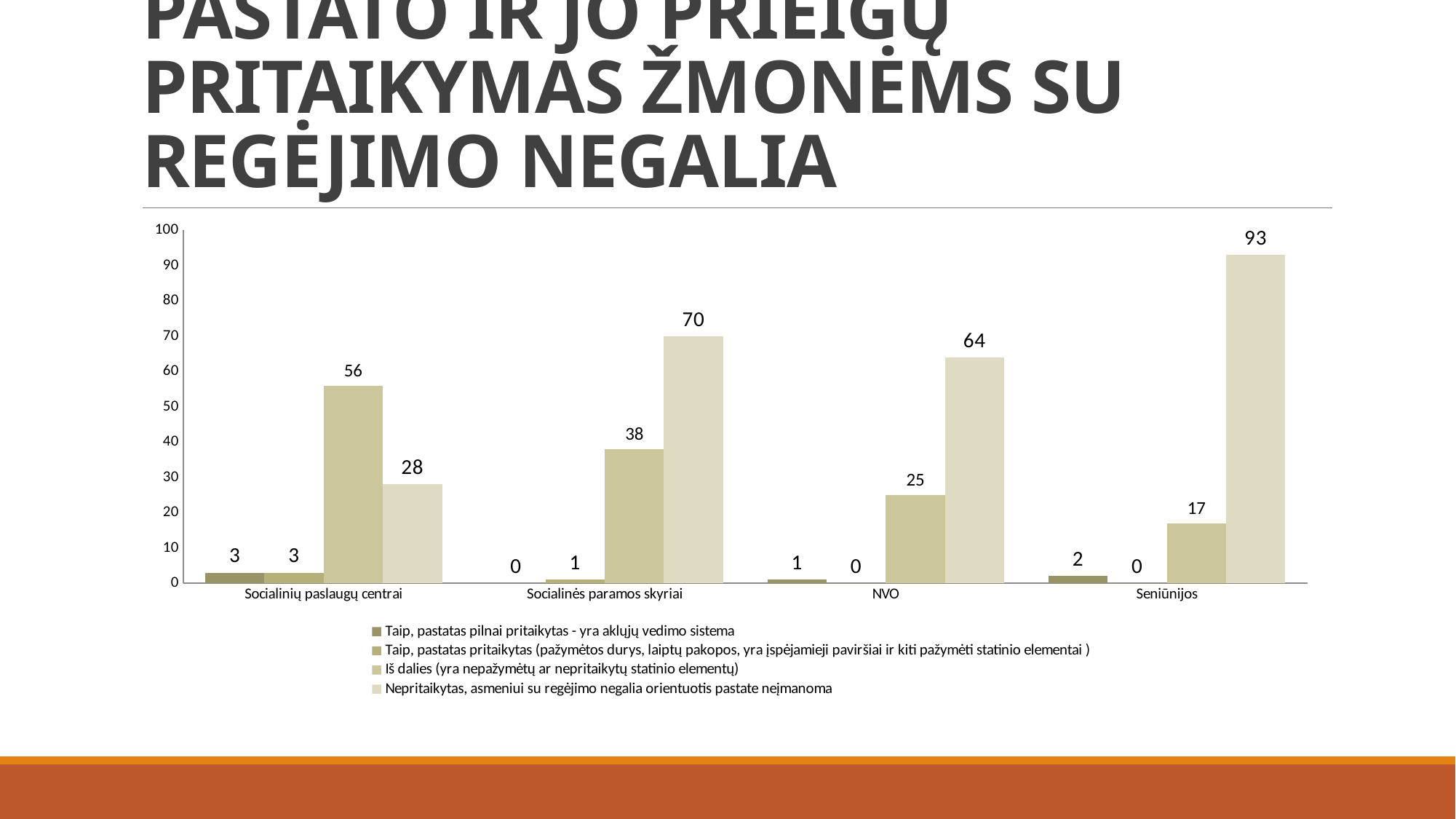
How many categories are shown on the x axis of the chart? 4 Is the 'Iš dalies' value for NVO greater or less than 30? less Which category has the highest value for the 'Nepritaikytas, asmeniui su regėjimo negalia orientuotis pastate neįmanoma' series? Seniūnijos What is the value of the 'Nepritaikytas, asmeniui su regėjimo negalia orientuotis pastate neįmanoma' series for Seniūnijos? 93 What is the difference between the 'Nepritaikytas' value for Seniūnijos and the 'Nepritaikytas' value for Socialinių paslaugų centrai? 65 What is the value of the 'Nepritaikytas, asmeniui su regėjimo negalia orientuotis pastate neįmanoma' series for NVO? 64 For Socialinės paramos skyriai, which is larger: the 'Iš dalies' value or the 'Nepritaikytas' value? Nepritaikytas What is the value of the 'Iš dalies (yra nepažymėtų ar nepritaikytų statinio elementų)' series for Socialinių paslaugų centrai? 56 What is the value of the 'Taip, pastatas pilnai pritaikytas - yra aklųjų vedimo sistema' series for Seniūnijos? 2 How many series does the chart's legend list? 4 Which category has the lowest value for the 'Iš dalies (yra nepažymėtų ar nepritaikytų statinio elementų)' series? Seniūnijos What type of chart is shown on the slide? bar chart